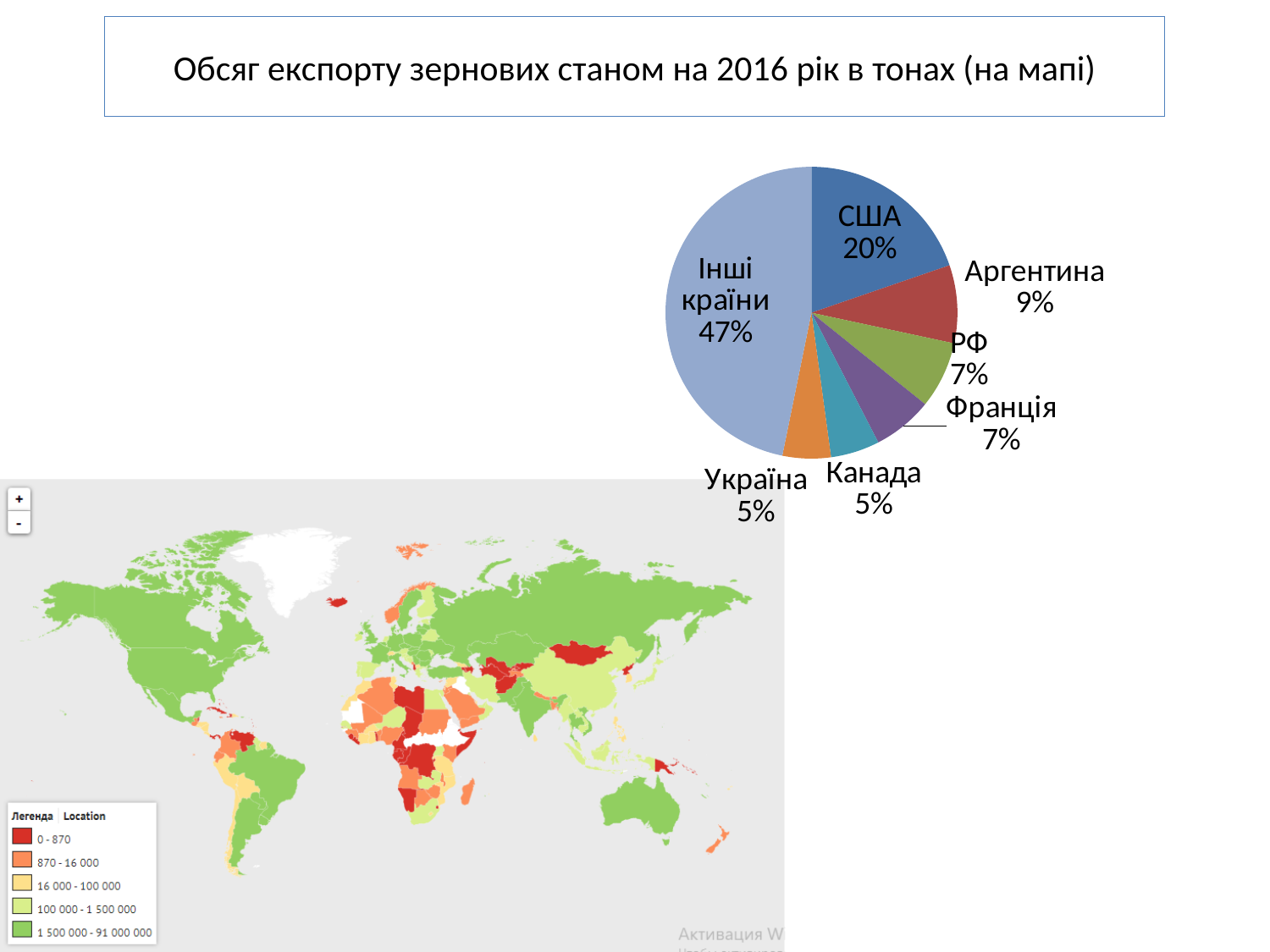
On the pie chart, which named country has the largest share? США On the pie chart, what is the difference between the shares of США and Аргентина? 11% On the pie chart, what share does США have? 20% On the pie chart, which slice is the largest? Інші країни On the pie chart, what share does Франція have? 7% On the pie chart, what share does Україна have? 5% How many slices does the pie chart have? 7 On the pie chart, which is larger, the share of Аргентина or the share of РФ? Аргентина On the pie chart, what share does Аргентина have? 9% On the pie chart, what is the difference between the shares of Інші країни and США? 27% What kind of chart is shown in the upper right of the slide? Pie chart What is the title of the slide? Обсяг експорту зернових станом на 2016 рік в тонах (на мапі)